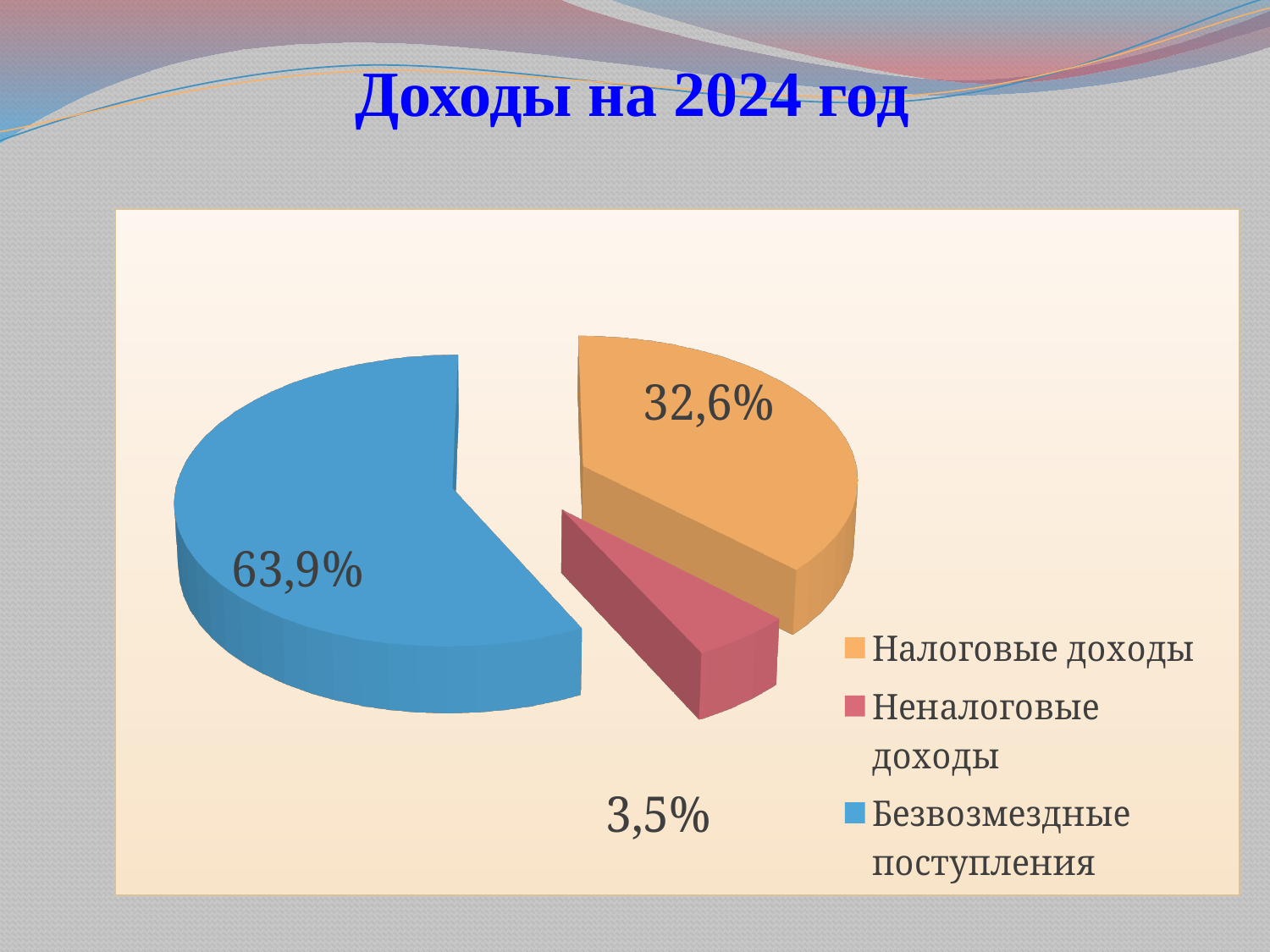
What is the difference between the shares of Налоговые доходы and Неналоговые доходы? 29,1% What is the difference between the shares of Безвозмездные поступления and Налоговые доходы? 31,3% What colour is the slice for Безвозмездные поступления? Blue What share of the pie does Безвозмездные поступления have? 63,9% Which is larger: the share of Налоговые доходы or the share of Неналоговые доходы? Налоговые доходы What kind of chart is shown on the slide? Pie chart Which category has the smallest share of the pie? Неналоговые доходы What is the title of the slide? Доходы на 2024 год What share of the pie does Неналоговые доходы have? 3,5% Which category has the largest share of the pie? Безвозмездные поступления What share of the pie does Налоговые доходы have? 32,6% How many slices does the pie chart have? 3